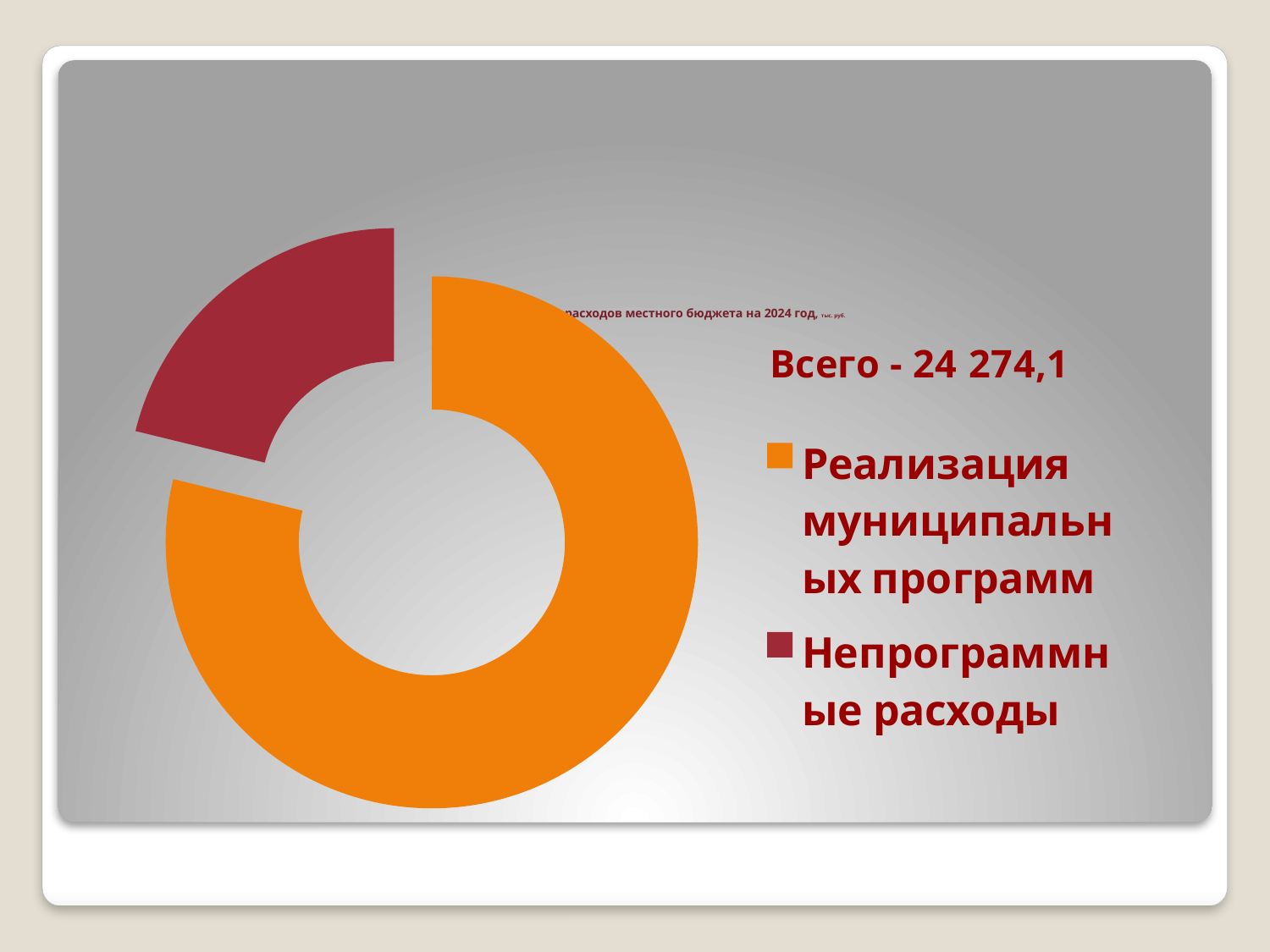
Which category has the largest slice in the chart? Реализация муниципальных программ How many entries does the legend list? 2 What total value (Всего) is printed next to the chart? 24 274,1 What colour is the slice for Непрограммные расходы? Dark red How many slices does the doughnut chart have? 2 Which is larger: the slice for Реализация муниципальных программ or the slice for Непрограммные расходы? Реализация муниципальных программ What kind of chart is shown on the slide? Doughnut chart Which category has the smallest slice in the chart? Непрограммные расходы